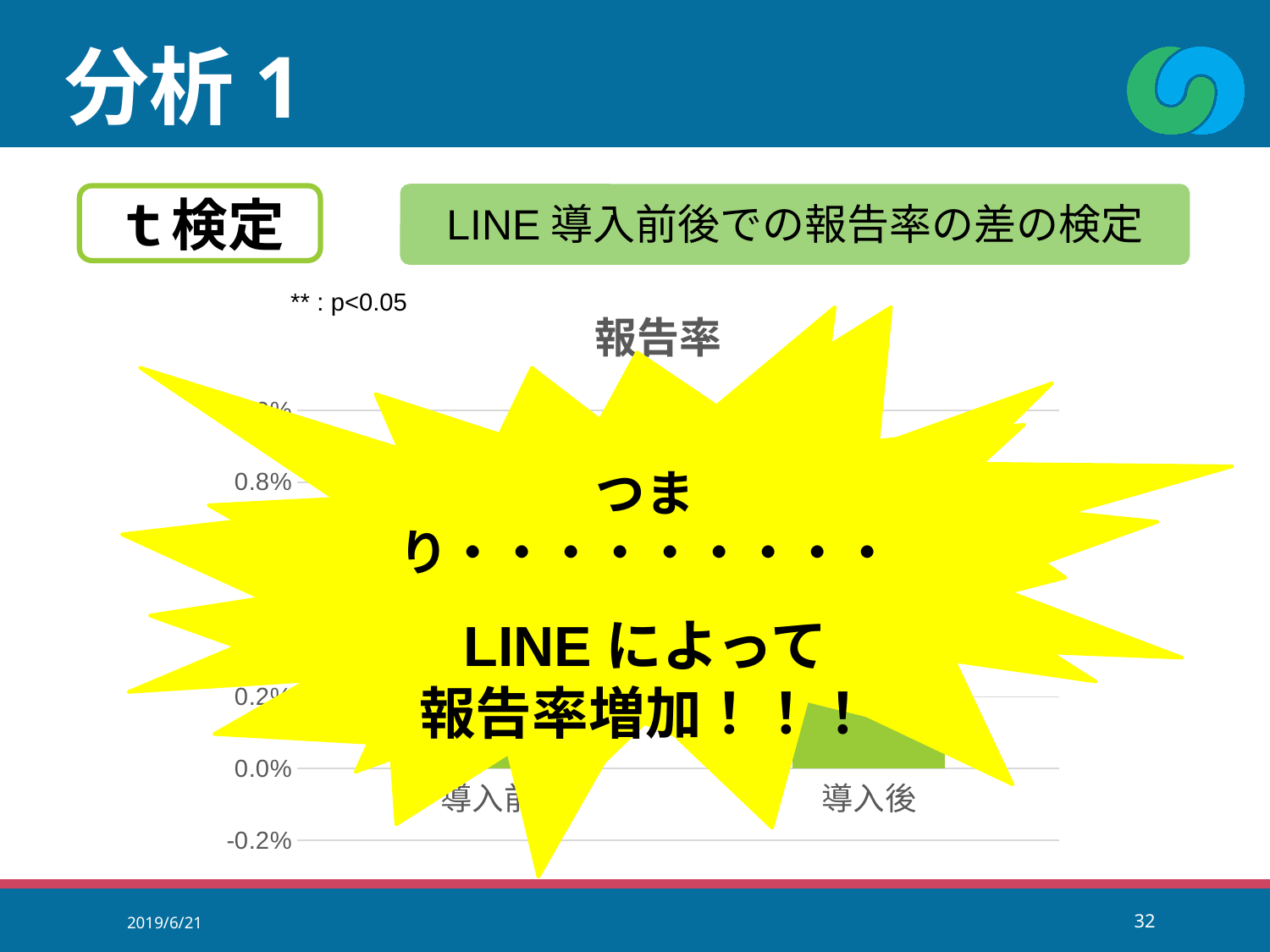
What is the lowest tick label shown on the y axis of the chart? -0.2% What is the title of the chart on the slide? 報告率 Is the value for 導入後 greater or less than 0.0%? greater How many categories are shown on the x axis of the chart? 2 What kind of chart is shown on the slide? bar chart